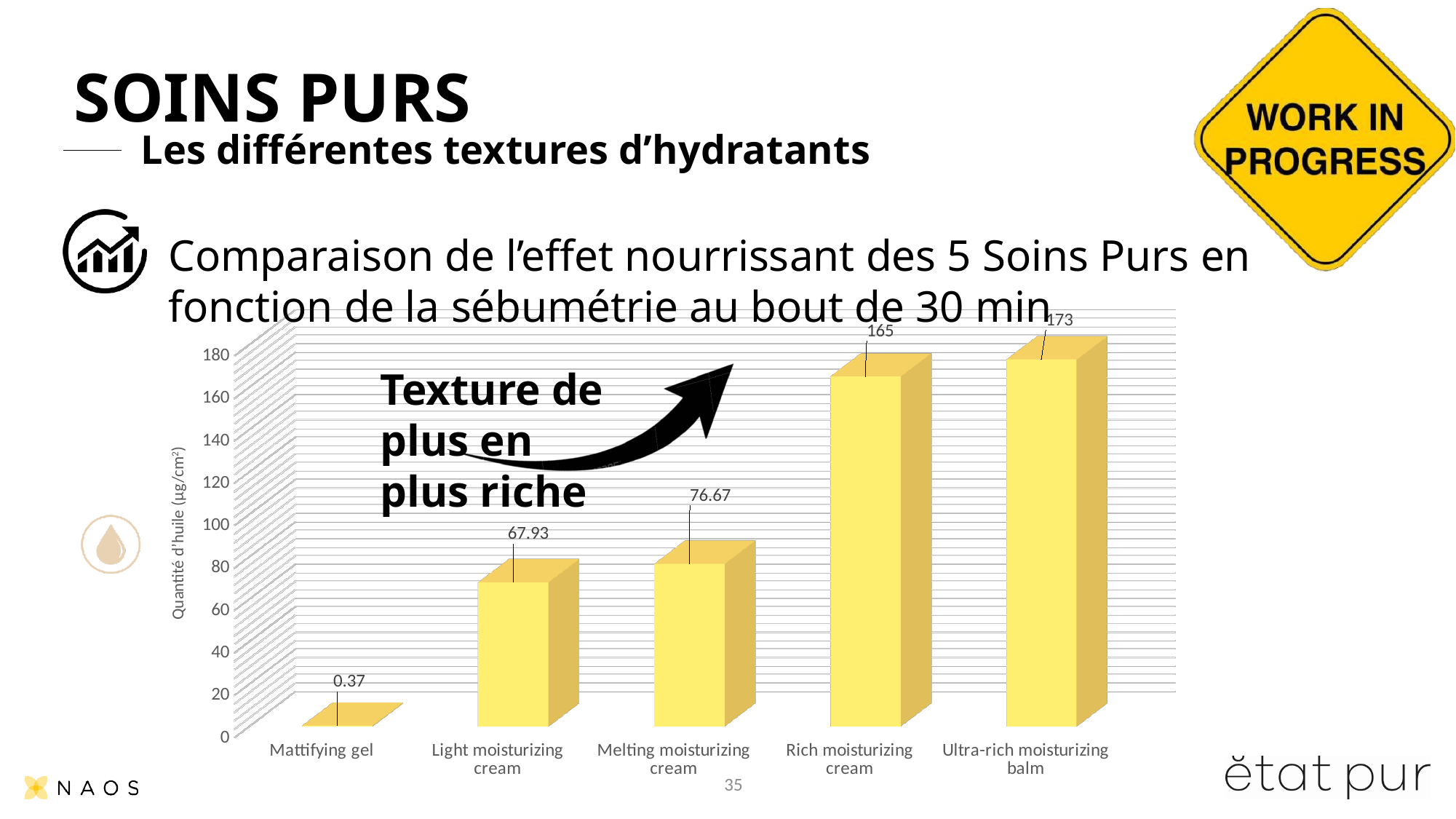
Which category has the highest value? Ultra-rich moisturizing balm What is the value for Mattifying gel? 0.37 What is the value for Light moisturizing cream? 67.93 What is the value for Ultra-rich moisturizing balm? 173 How many categories are shown on the x axis? 5 What is the label of the vertical axis? Quantité d'huile (µg/cm²) What kind of chart is shown? Bar chart Which category has the lowest value? Mattifying gel Which is larger, the value for Melting moisturizing cream or Light moisturizing cream? Melting moisturizing cream What is the difference between the values for Ultra-rich moisturizing balm and Rich moisturizing cream? 8 What is the value for Rich moisturizing cream? 165 What is the value for Melting moisturizing cream? 76.67